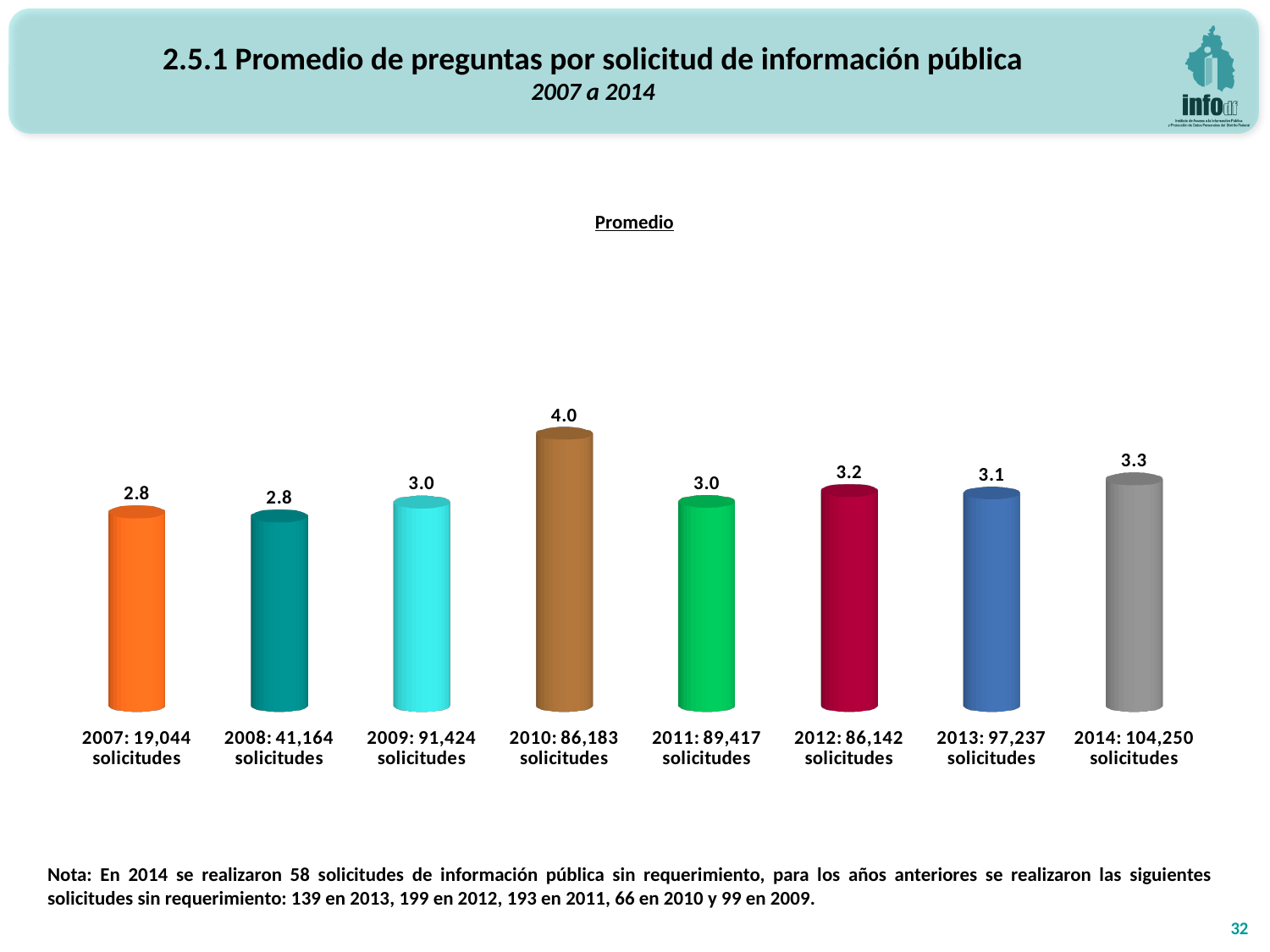
How many years (bars) are shown in the chart? 8 Which year has the highest promedio value? 2010 What is the average number of questions per request (promedio) for 2010? 4.0 Does the promedio value rise or fall from 2010 to 2011? Fall What is the difference between the promedio values for 2010 and 2014? 0.7 What is the promedio value shown for 2007? 2.8 How many solicitudes are indicated in the category label for 2014? 104,250 What is the title printed above the chart? Promedio What kind of chart is shown on the slide? Bar chart Which is larger, the promedio value for 2012 or for 2011? 2012 What is the difference between the promedio values for 2012 and 2013? 0.1 What is the promedio value shown for 2014? 3.3